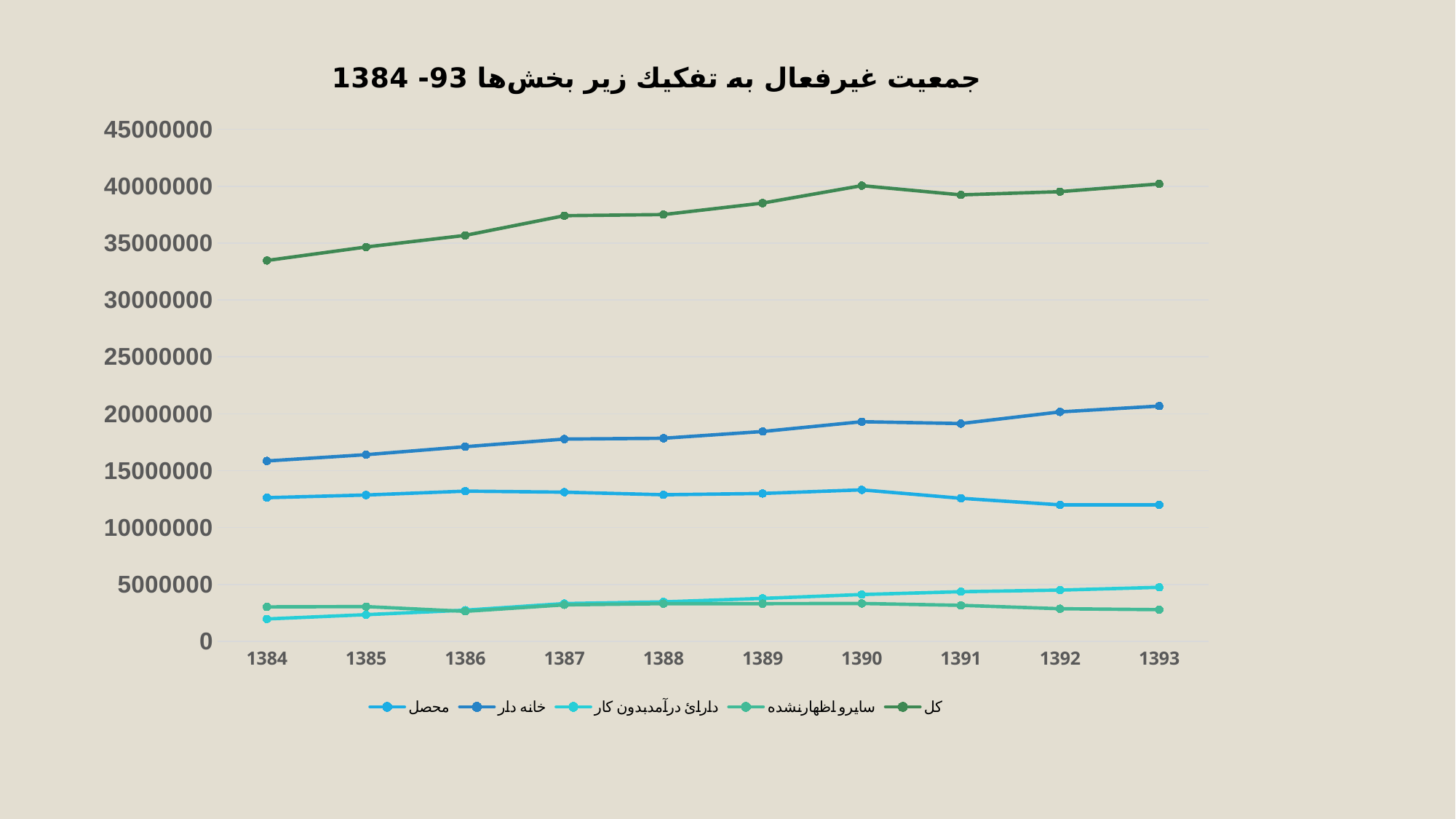
Which series has the lowest value in 1384? دارای درآمد بدون کار In 1393, which is larger: دارای درآمد بدون کار or سایر و اظهارنشده? دارای درآمد بدون کار What is the title of the chart? جمعيت غيرفعال به تفكيك زير بخش‌ها 93- 1384 Is the value for خانه‌دار in 1384 greater or less than 20000000? less Does the value for کل generally rise or fall from 1384 to 1393? Rise Is the value for محصل in 1393 greater or less than 15000000? less Is the value for کل in 1384 greater or less than 35000000? less How many series does the legend list? 5 Which series has the highest value in 1393? کل What kind of chart is shown on the slide? Line chart How many years are plotted along the x axis? 10